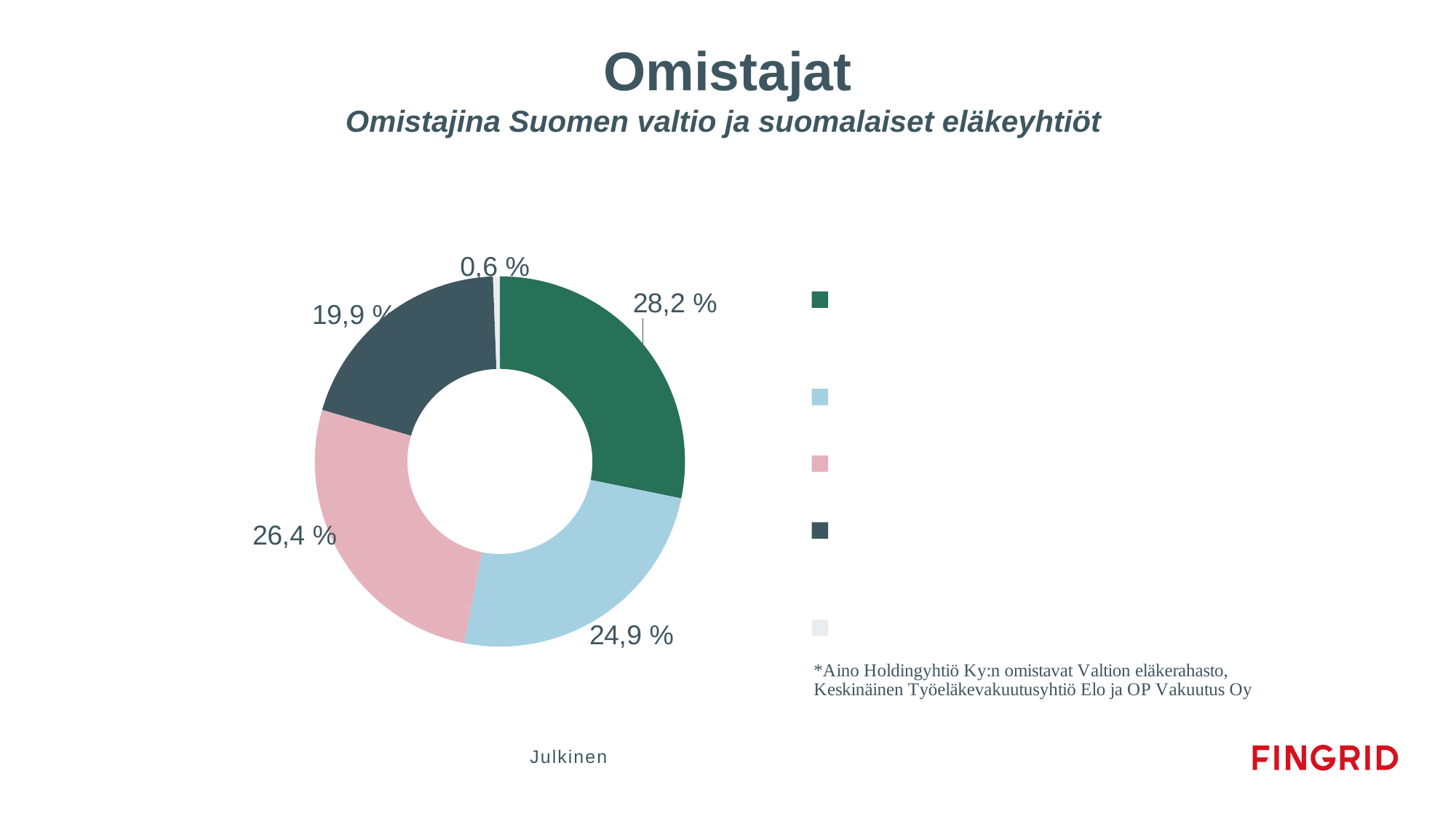
What value is shown for the dark grey slice? 19,9 % How many entries does the legend list? 5 What is the title of the chart on the slide? Omistajat What value is shown for the light blue slice? 24,9 % How many slices does the doughnut chart have? 5 What value is shown for the pink slice? 26,4 % What kind of chart is shown on the slide? doughnut (pie) chart What value is shown for the dark green slice? 28,2 % What is the difference between the largest slice (28,2 %) and the light blue slice (24,9 %)? 3,3 % What is the value of the smallest slice in the chart? 0,6 % Which is larger, the pink slice or the dark grey slice? the pink slice (26,4 %) What is the value of the largest slice in the chart? 28,2 %